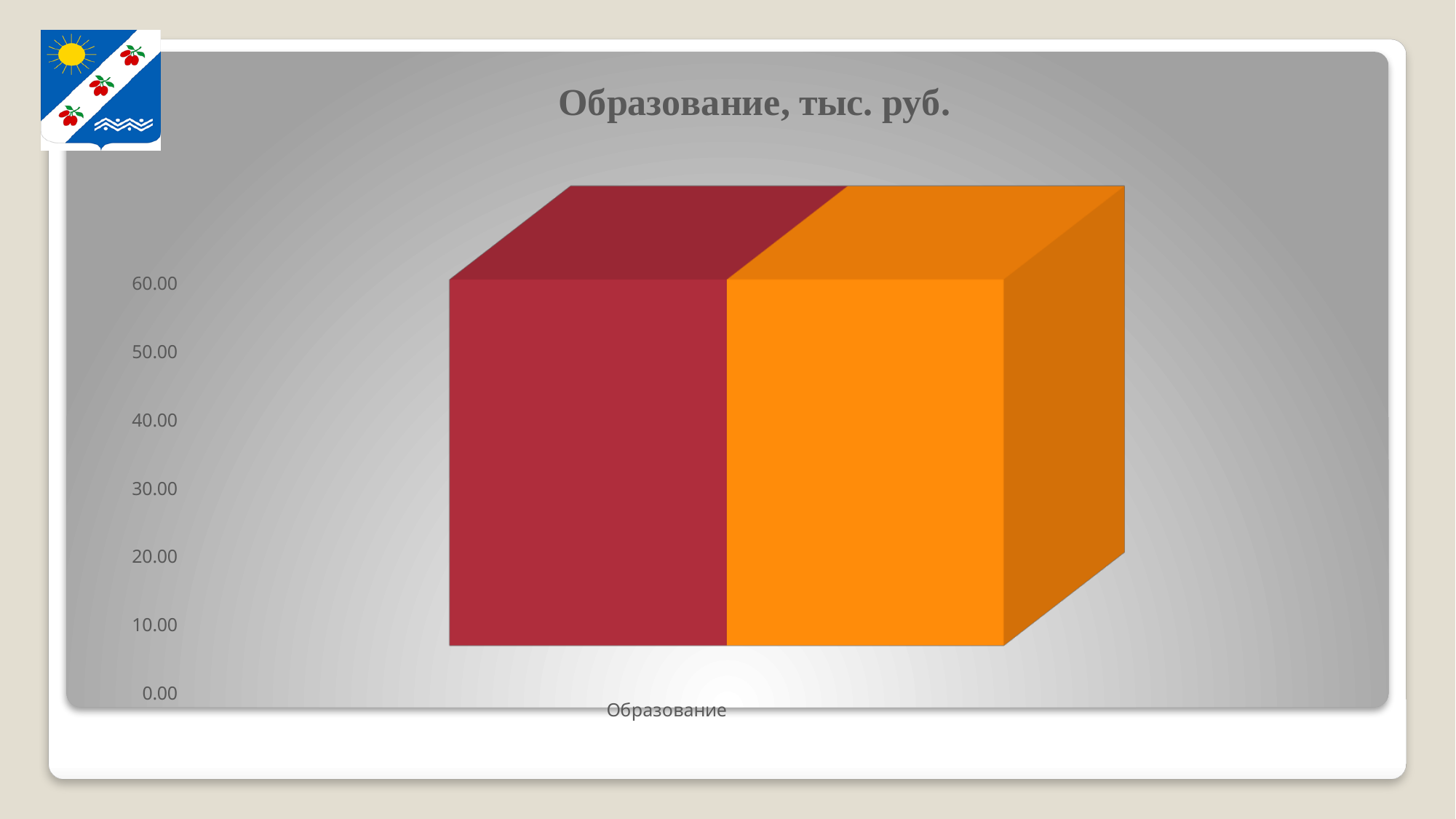
What is the category label shown on the x axis? Образование Is the value of the red bar for Образование greater or less than 40.00? greater How many categories are shown on the x axis of the chart? 1 What is the highest tick value shown on the vertical axis of the chart? 60.00 Is the value of the orange bar for Образование greater or less than 50.00? greater How many bars are plotted for the category Образование? 2 Is the value of the orange bar for Образование greater or less than 30.00? greater What is the title of the chart? Образование, тыс. руб. What kind of chart is shown on the slide? bar chart